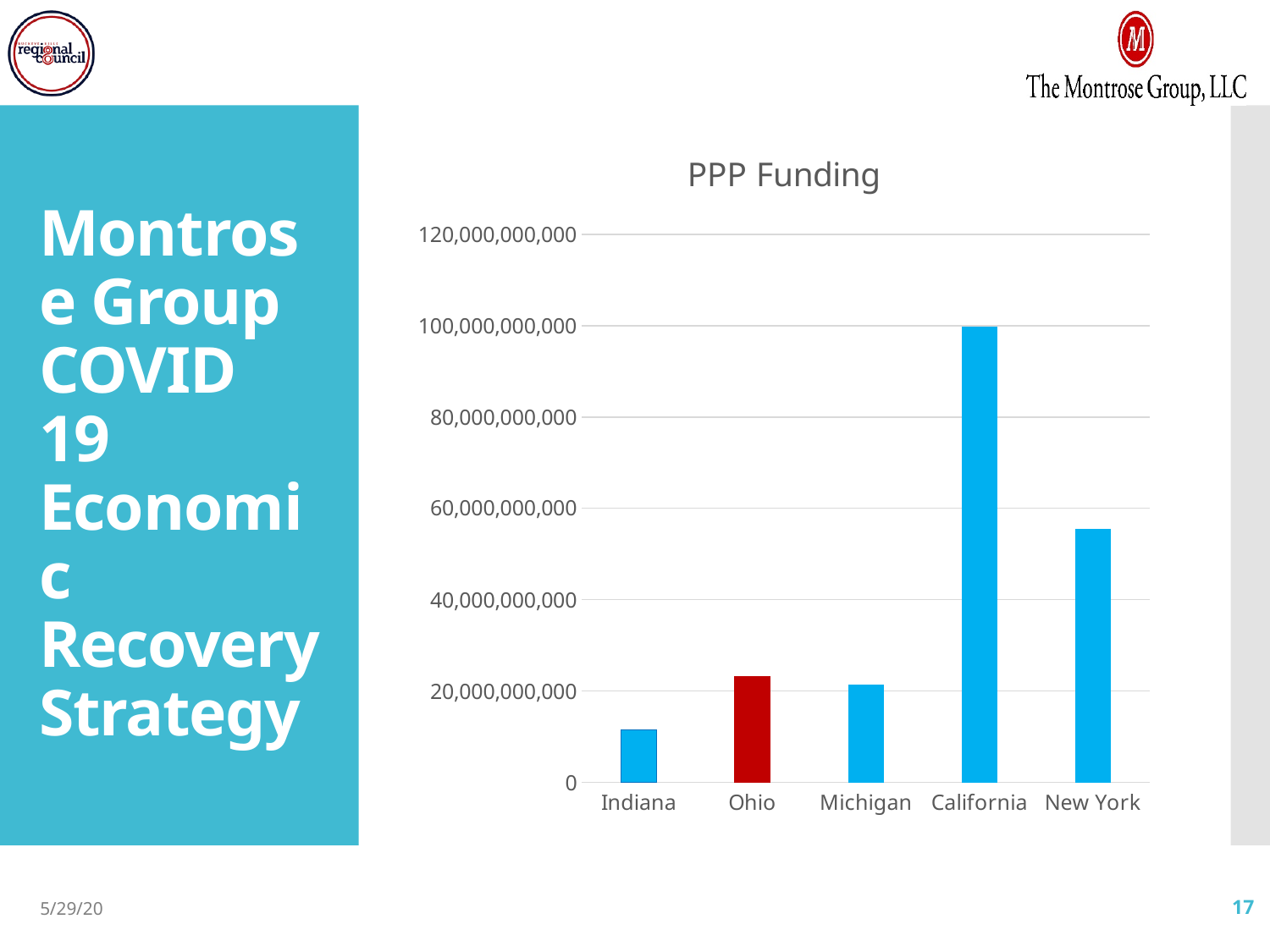
Is the PPP Funding value for Indiana greater or less than 20,000,000,000? less What kind of chart is shown on the slide? bar chart How many states are shown on the x axis of the PPP Funding chart? 5 Which has higher PPP Funding, Ohio or Indiana? Ohio What is the title of the chart? PPP Funding Which state has the lowest PPP Funding? Indiana Is the PPP Funding value for California greater or less than 80,000,000,000? greater Which has higher PPP Funding, New York or Michigan? New York Is the PPP Funding value for New York greater or less than 40,000,000,000? greater Which state has the highest PPP Funding? California Which state's bar is coloured red in the chart? Ohio